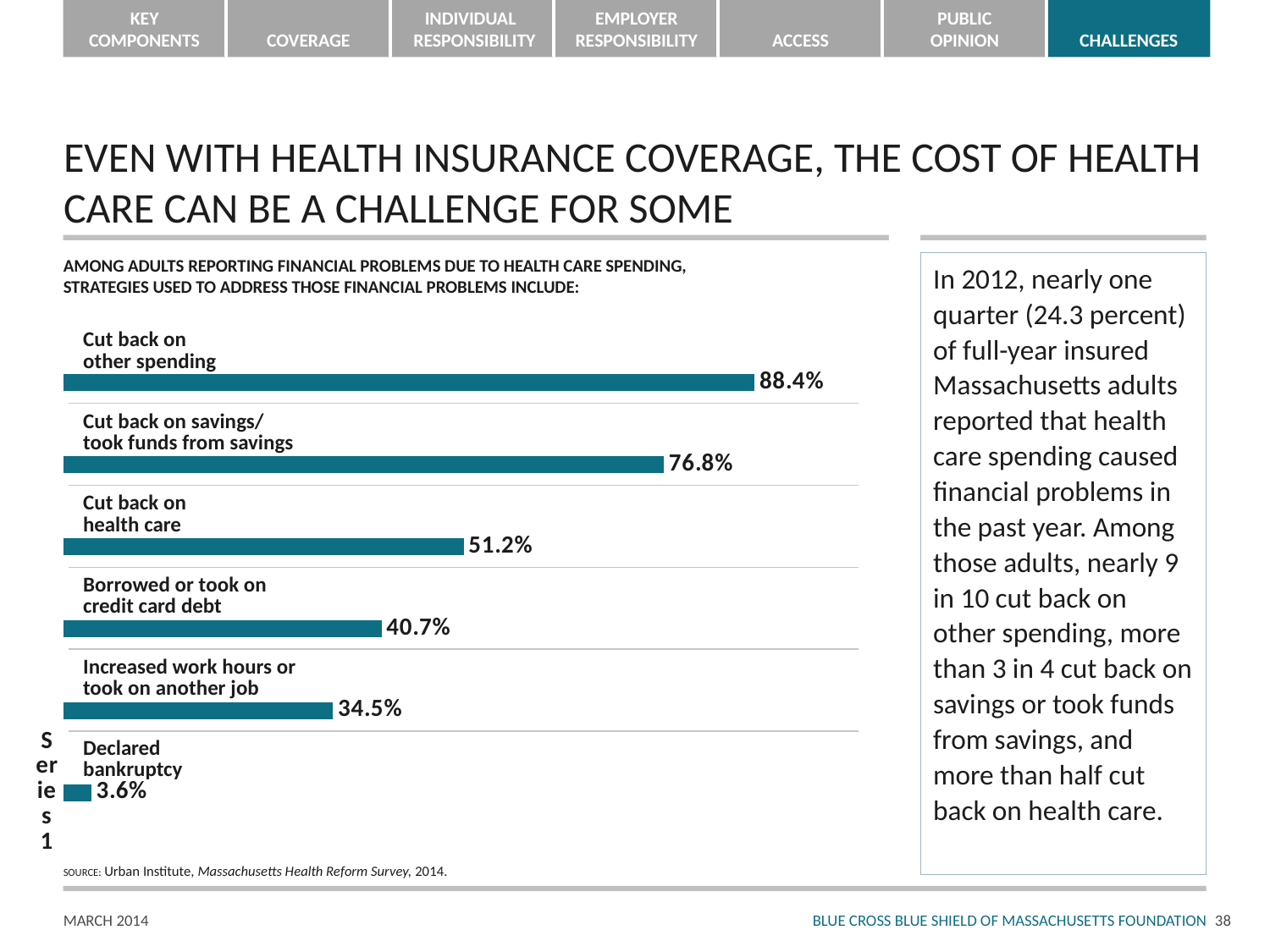
What is the value for 'Declared bankruptcy'? 3.6% Which strategy has the lowest value in the chart? Declared bankruptcy What is the source cited for the chart? Urban Institute, Massachusetts Health Reform Survey, 2014 What is the difference between 'Borrowed or took on credit card debt' and 'Increased work hours or took on another job'? 6.2% What is the value for 'Cut back on savings/took funds from savings'? 76.8% What percentage borrowed or took on credit card debt? 40.7% What kind of chart is shown on the slide? Bar chart How many strategies (categories) are shown in the chart? 6 Which strategy has the highest value in the chart? Cut back on other spending Which is larger: the value for 'Cut back on health care' or the value for 'Increased work hours or took on another job'? Cut back on health care What is the difference between 'Cut back on other spending' and 'Cut back on health care'? 37.2% What percentage of adults reporting financial problems due to health care spending cut back on other spending? 88.4%